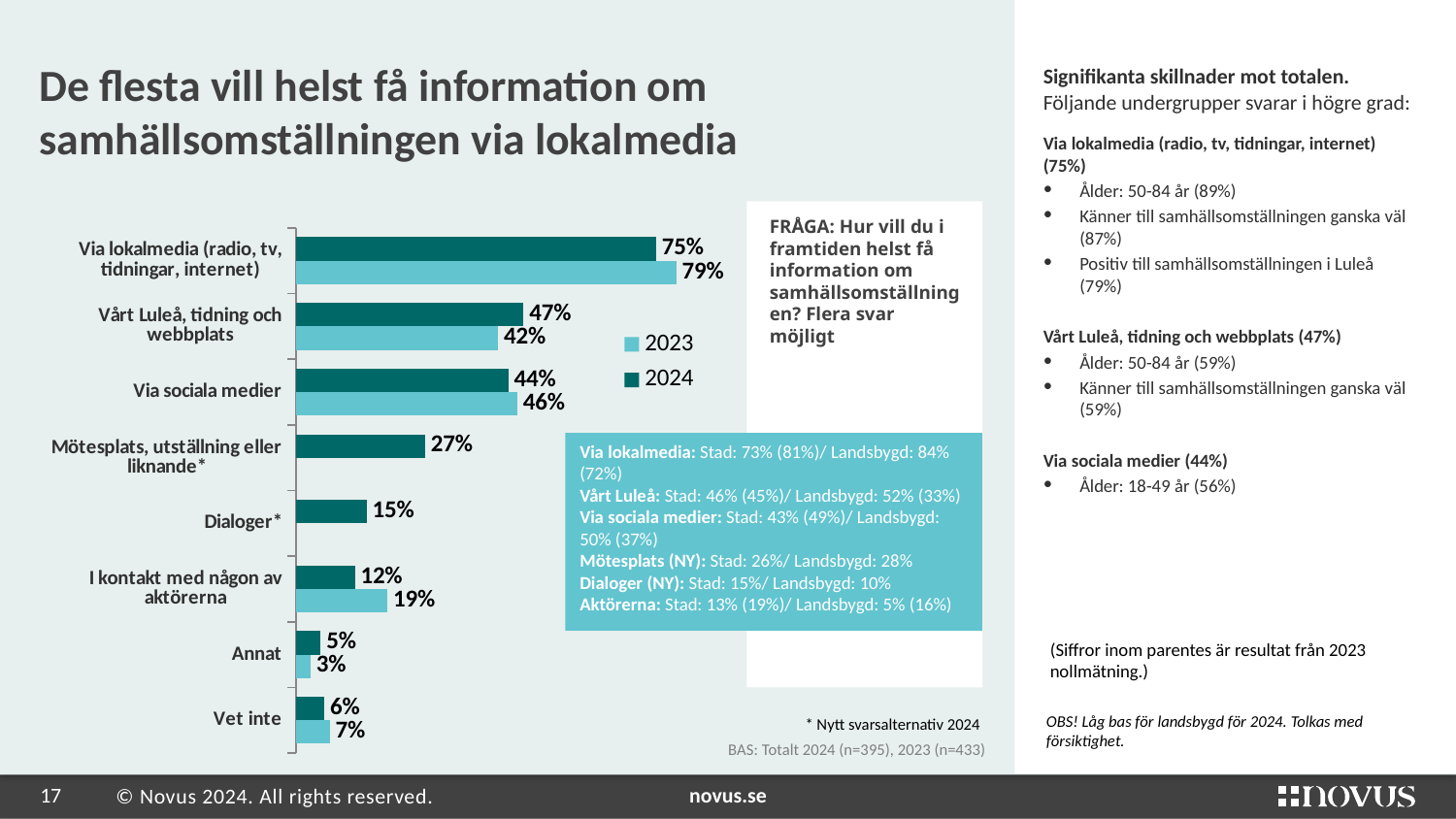
Which series is shown in the darker teal colour? 2024 What is the 2023 value for "I kontakt med någon av aktörerna"? 19% What is the 2024 value for "Mötesplats, utställning eller liknande*"? 27% How many series does the legend list? 2 What is the 2024 value for "Via lokalmedia (radio, tv, tidningar, internet)"? 75% What is the 2023 value for "Vårt Luleå, tidning och webbplats"? 42% What is the difference between the 2023 and 2024 values for "Via lokalmedia (radio, tv, tidningar, internet)"? 4 percentage points Which is larger for "Vårt Luleå, tidning och webbplats": the 2023 value or the 2024 value? 2024 Which category has the lowest 2023 value? Annat Which category has the highest 2024 value? Via lokalmedia (radio, tv, tidningar, internet) How many categories are shown on the chart? 8 What kind of chart is shown on the slide? Bar chart